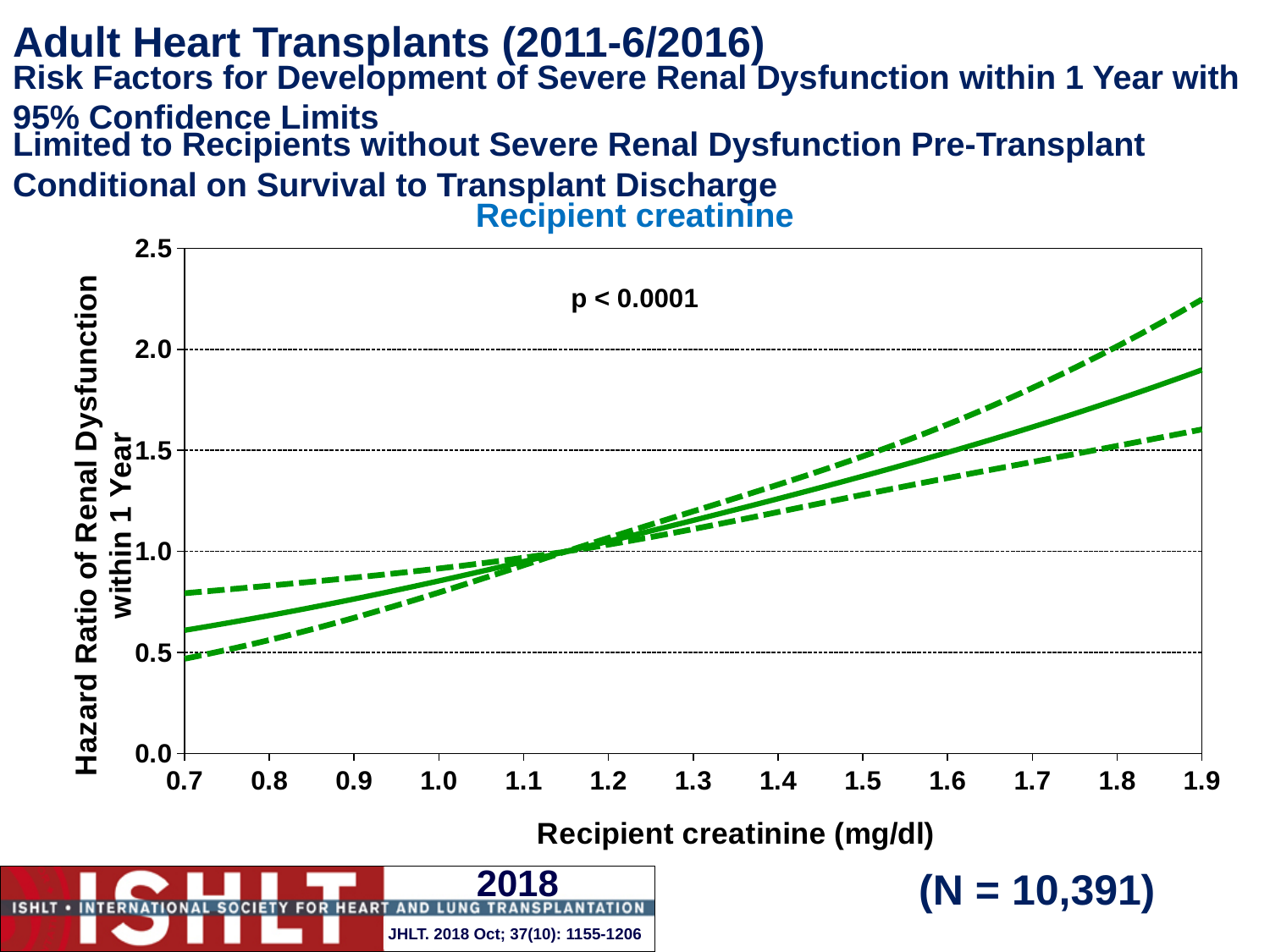
Is the hazard ratio on the solid line at a recipient creatinine of 1.0 mg/dl greater or less than 1.0? less How many tick labels are shown on the x axis? 13 Is the upper dashed confidence limit at a recipient creatinine of 0.7 mg/dl greater or less than 1.0? less How many lines are plotted on the chart? 3 What is the p-value printed on the chart? p < 0.0001 What kind of chart is shown on the slide? line chart Is the upper dashed confidence limit at a recipient creatinine of 1.9 mg/dl greater or less than 2.0? greater What is the label of the x axis? Recipient creatinine (mg/dl) Does the hazard ratio rise or fall as recipient creatinine increases along the x axis? rise